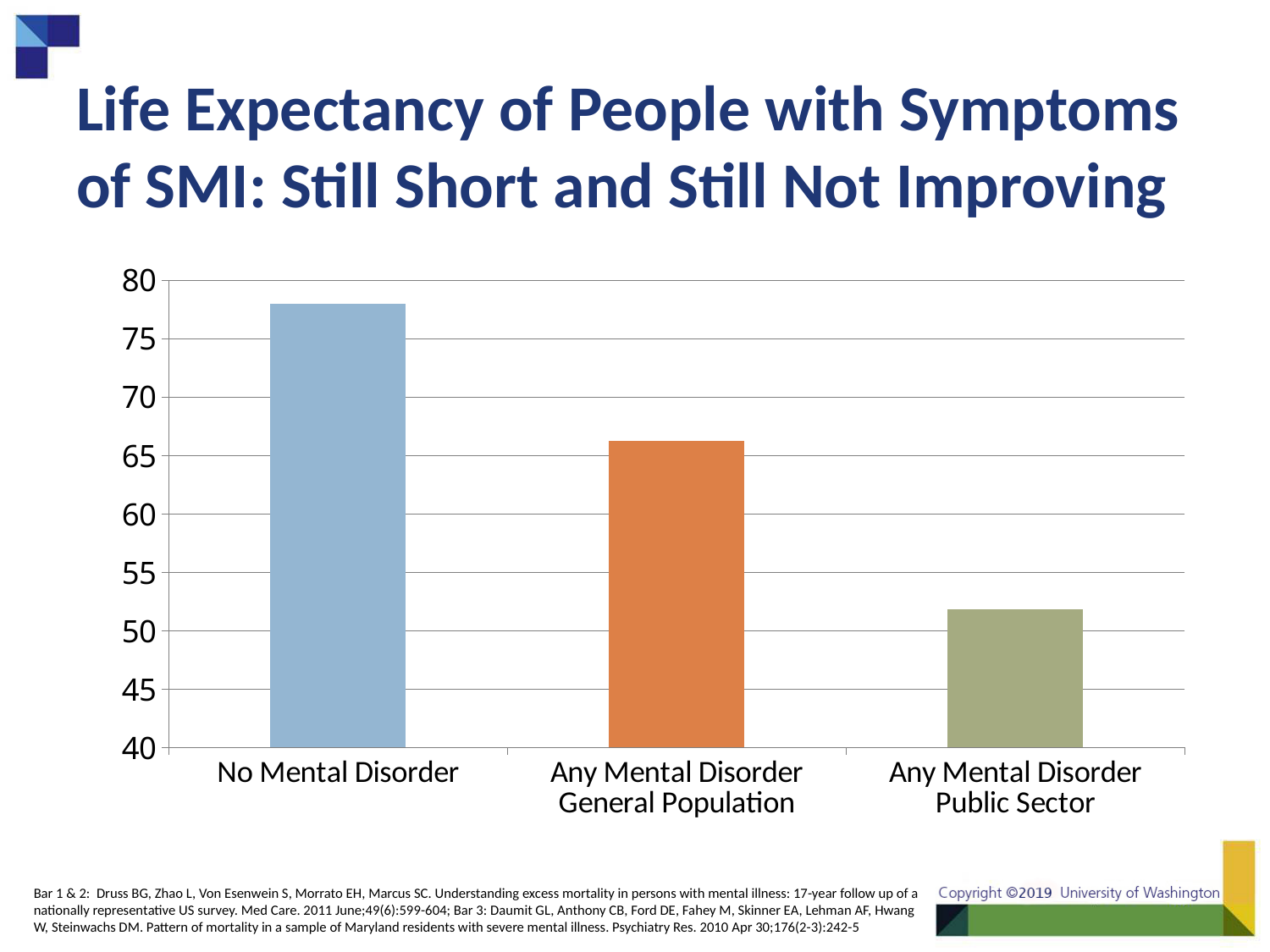
Is the value for Any Mental Disorder Public Sector greater or less than 55? less Do the bar values rise or fall from left to right across the categories? fall What is the title of the slide containing the chart? Life Expectancy of People with Symptoms of SMI: Still Short and Still Not Improving Is the value for No Mental Disorder greater or less than 75? greater How many categories are plotted in the chart? 3 Is the value for Any Mental Disorder General Population greater or less than 70? less Which is larger, the value for Any Mental Disorder General Population or the value for Any Mental Disorder Public Sector? Any Mental Disorder General Population What kind of chart is shown on the slide? bar chart Which category has the highest bar? No Mental Disorder Which category has the lowest bar? Any Mental Disorder Public Sector